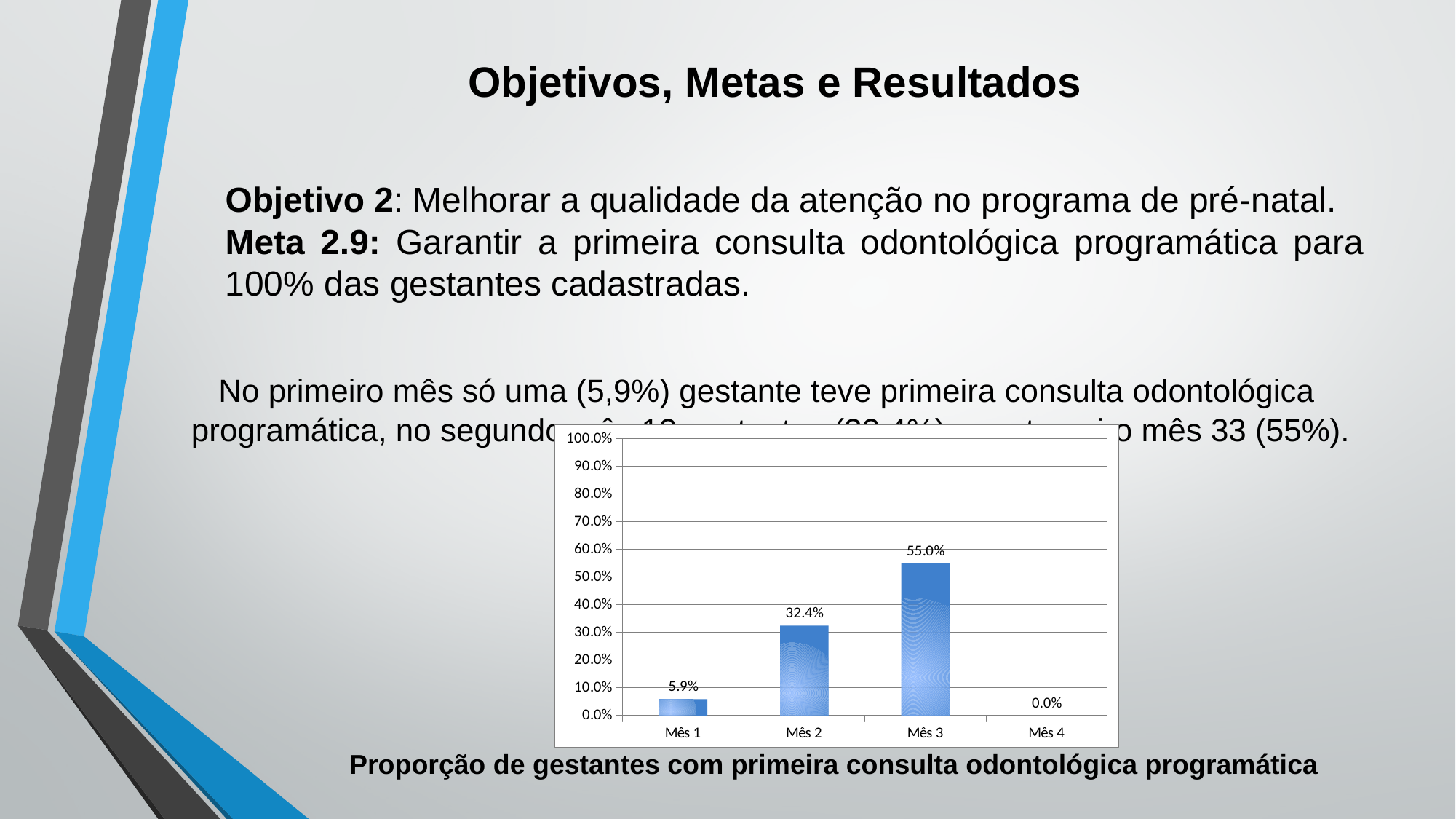
Which is larger, the value for Mês 1 or the value for Mês 2? Mês 2 How many months are shown on the x axis? 4 What is the difference between the values for Mês 3 and Mês 2? 22.6% What kind of chart is shown on the slide? bar chart What is the value for Mês 1? 5.9% Which month has the highest value? Mês 3 What is the value for Mês 4? 0.0% What is the value for Mês 2? 32.4% What is the caption printed below the chart? Proporção de gestantes com primeira consulta odontológica programática Is the value for Mês 3 greater or less than 50.0%? greater What is the value for Mês 3? 55.0% Which month has the lowest value? Mês 4